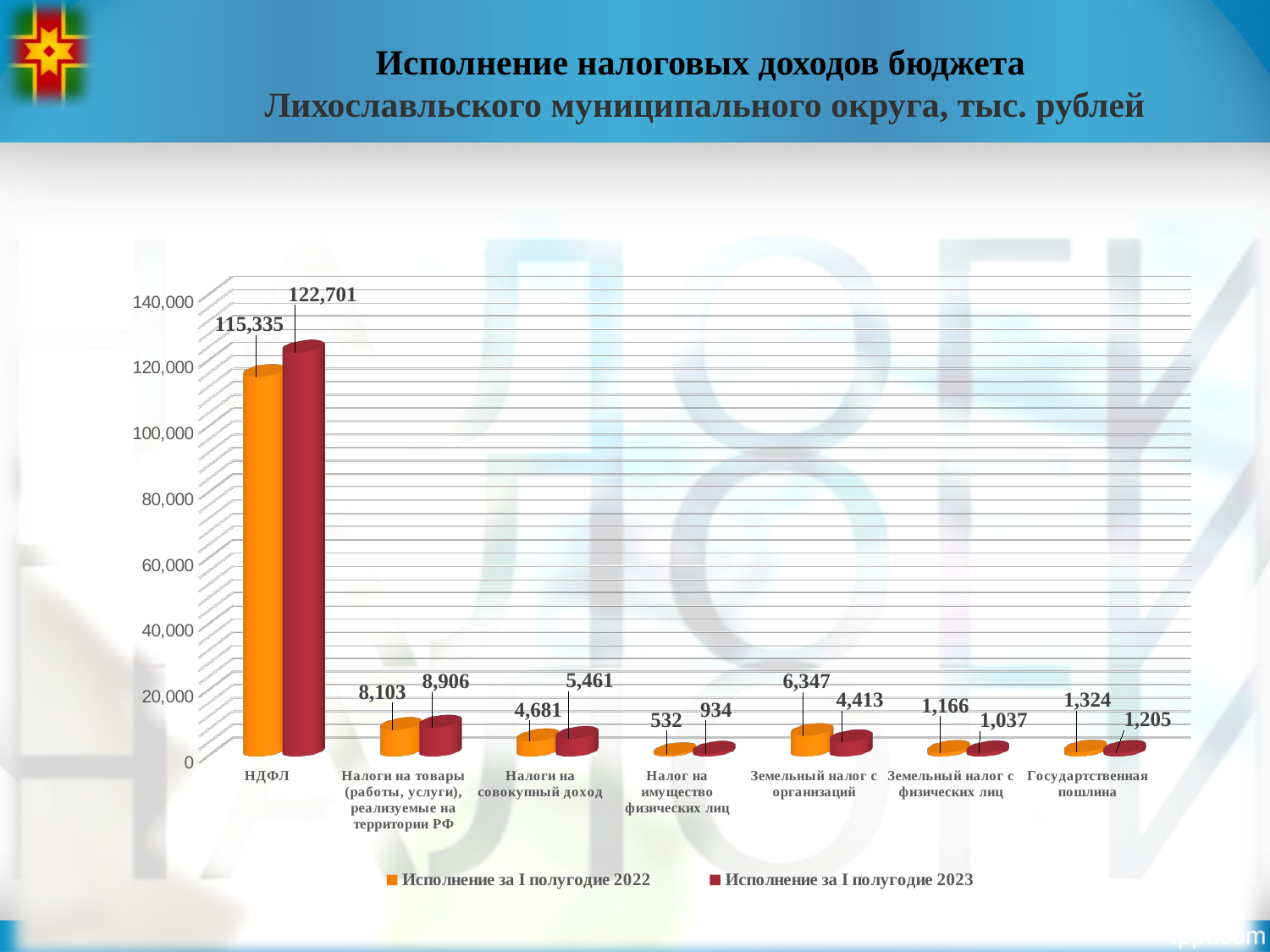
What kind of chart is shown on the slide? Bar chart For Государственная пошлина, which series has the larger value: Исполнение за I полугодие 2022 or Исполнение за I полугодие 2023? Исполнение за I полугодие 2022 Which category has the highest value in the series Исполнение за I полугодие 2022? НДФЛ How many categories are shown on the x axis? 7 Which category has the lowest value in the series Исполнение за I полугодие 2023? Налог на имущество физических лиц How many series does the legend list? 2 What is the difference between the 2023 and 2022 values for НДФЛ? 7,366 What is the value for Земельный налог с организаций in the series Исполнение за I полугодие 2023? 4,413 Is the value for НДФЛ in the series Исполнение за I полугодие 2022 greater or less than 100,000? greater What is the value for Налог на имущество физических лиц in the series Исполнение за I полугодие 2022? 532 What is the difference between the 2022 and 2023 values for Земельный налог с организаций? 1,934 What is the value for НДФЛ in the series Исполнение за I полугодие 2023? 122,701